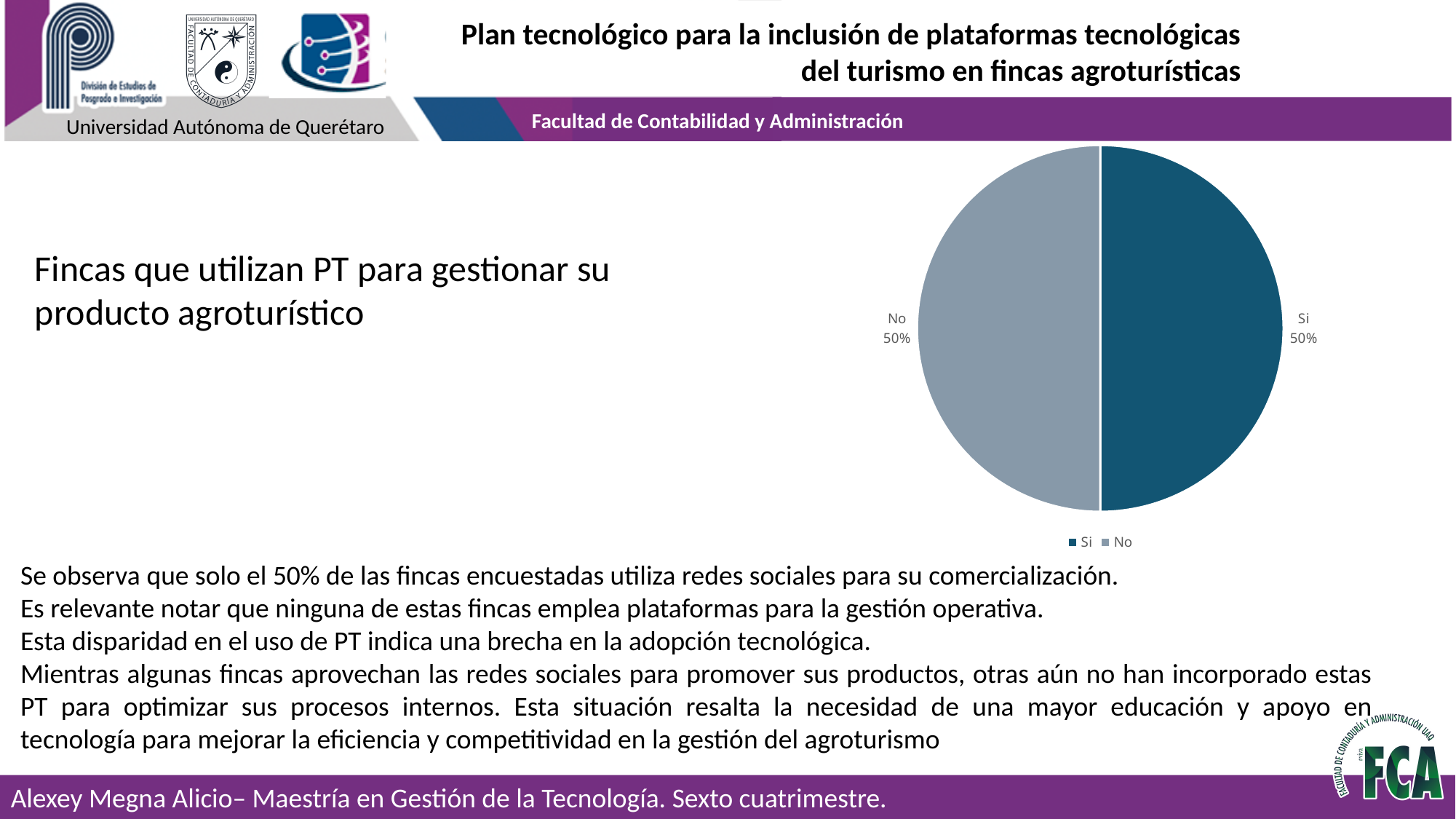
How many entries does the legend of the pie chart list? 2 What kind of chart is shown on the slide? pie chart Which entries are listed in the legend of the pie chart? Si, No What share of the pie does the "Si" slice represent? 50% What share of the pie does the "No" slice represent? 50% What is the difference between the "Si" and "No" shares in the pie chart? 0% How many slices does the pie chart have? 2 Which slice of the pie chart is coloured dark blue? Si What is the total of the "Si" and "No" shares shown in the pie chart? 100%